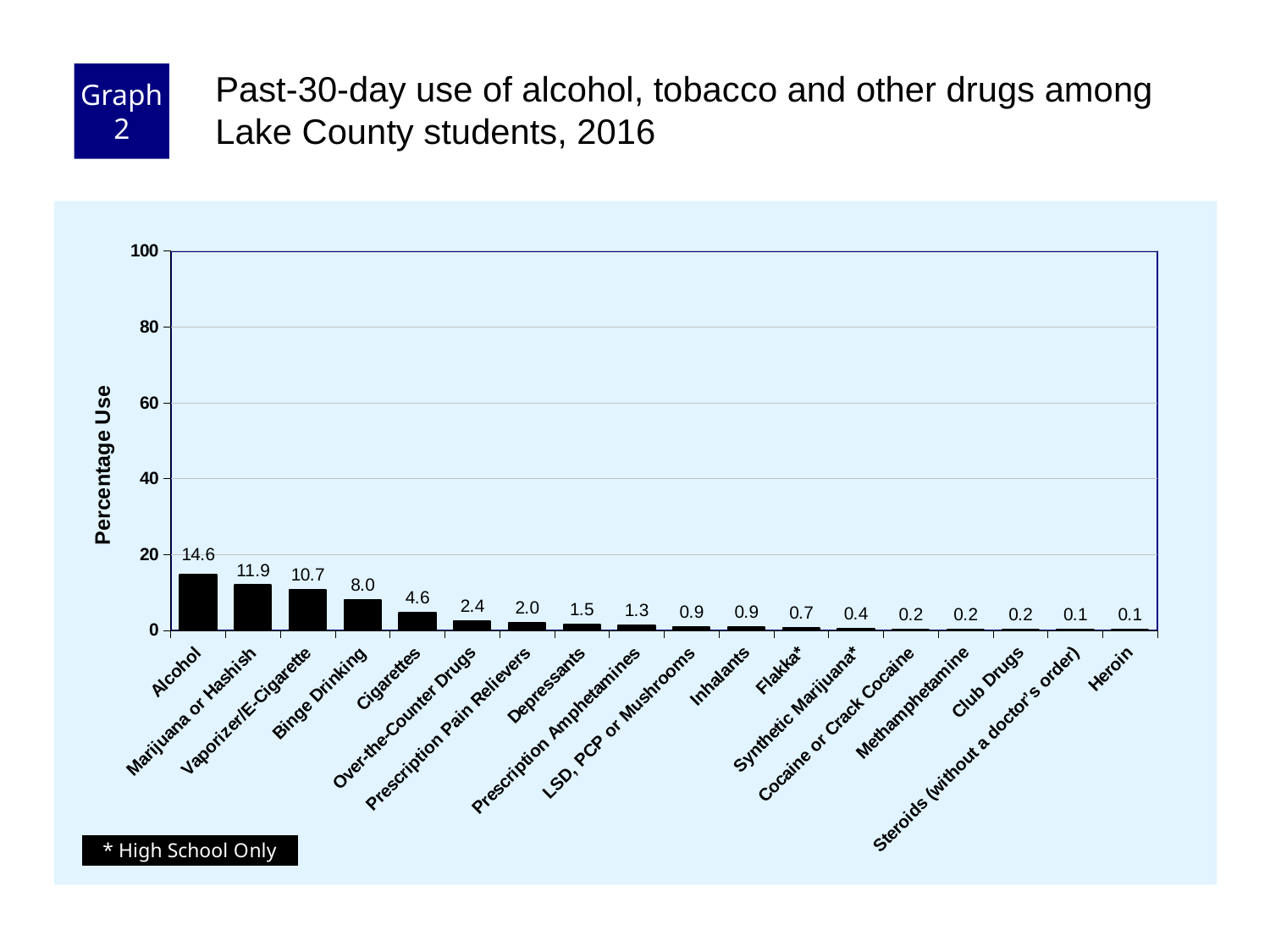
What kind of chart is shown on the slide? bar chart Which category has the highest percentage use? Alcohol What is the label of the y axis? Percentage Use What is the percentage use for Alcohol? 14.6 How many categories are shown on the x axis? 18 Which has a higher percentage use, Over-the-Counter Drugs or Depressants? Over-the-Counter Drugs What is the percentage use for Vaporizer/E-Cigarette? 10.7 What is the percentage use for Cigarettes? 4.6 Is the value for Alcohol greater or less than 20? less What is the difference in percentage use between Alcohol and Marijuana or Hashish? 2.7 What is the difference in percentage use between Binge Drinking and Cigarettes? 3.4 What is the percentage use for Flakka*? 0.7